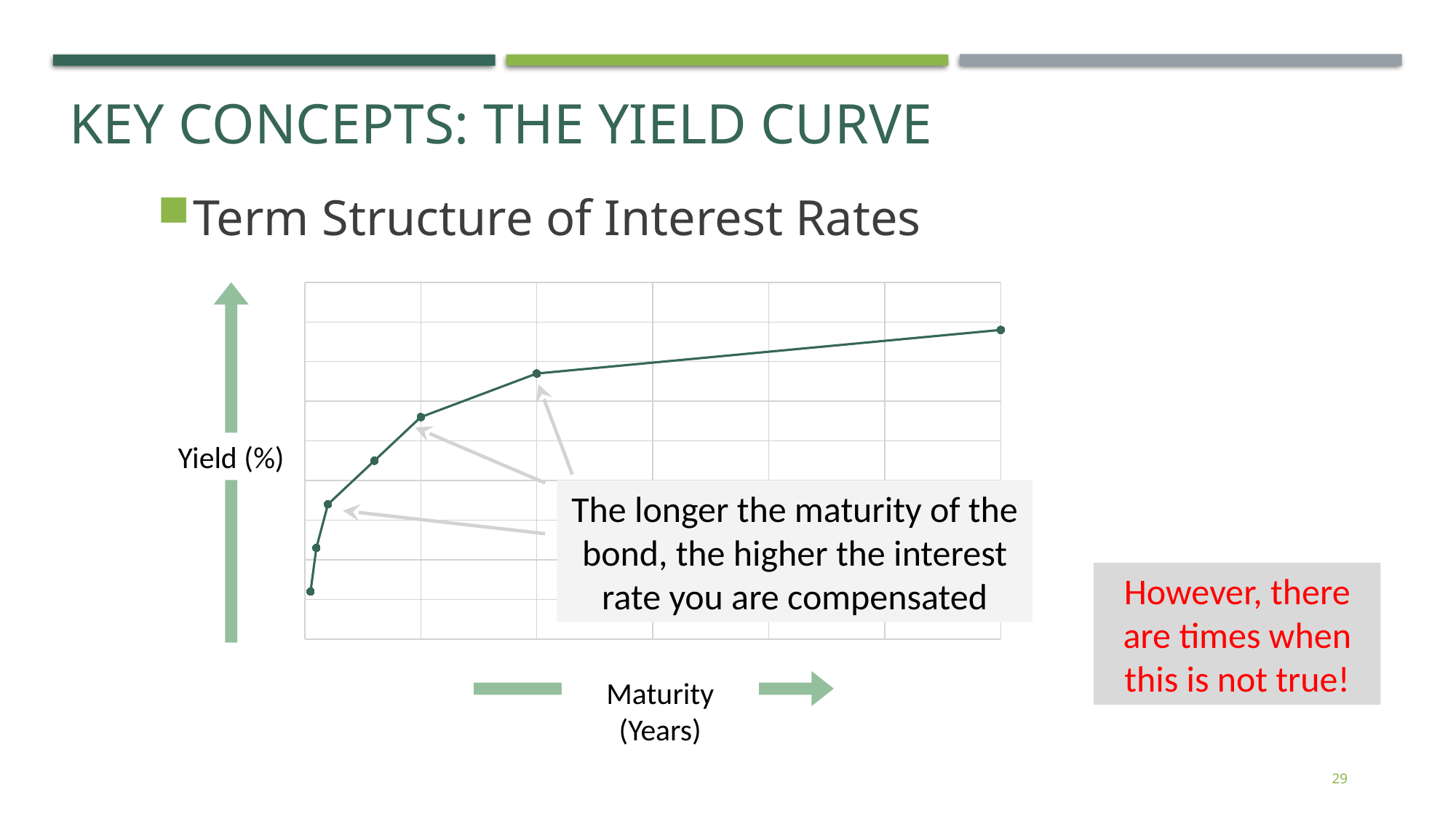
How many lines (series) are plotted on the chart? 1 How many data points are marked on the yield curve? 7 Is the steepest rise of the yield curve at short maturities or at long maturities? short maturities Does the yield rise or fall as maturity increases along the x axis? rise What kind of chart is shown on the slide? line chart Which has the higher yield on the chart: the shortest maturity or the longest maturity? the longest maturity What is the label of the horizontal axis of the chart? Maturity (Years) What is the label of the vertical axis of the chart? Yield (%)